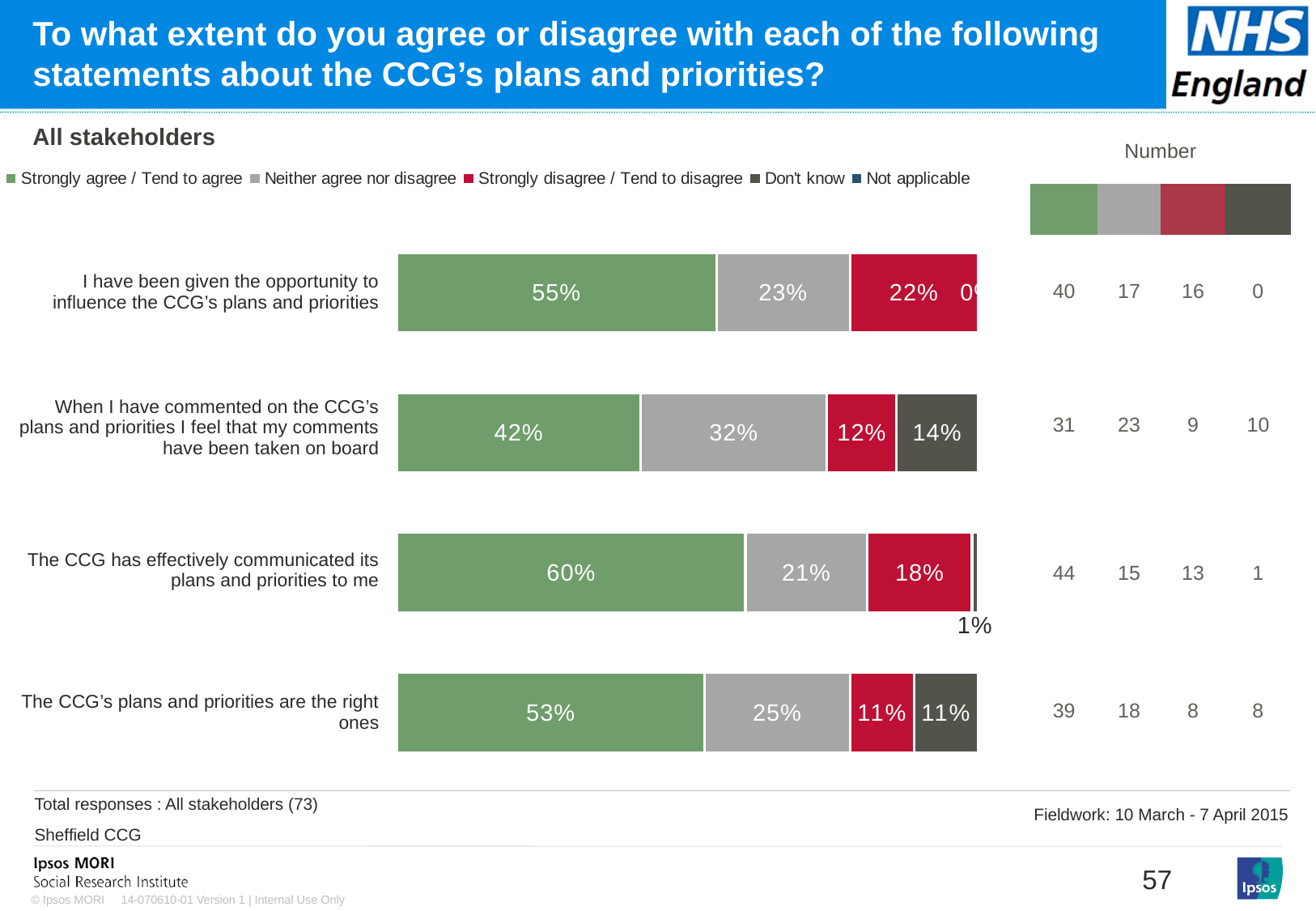
What percentage of stakeholders strongly disagree or tend to disagree that they have been given the opportunity to influence the CCG's plans and priorities? 22% What percentage of stakeholders neither agree nor disagree with the statement 'When I have commented on the CCG's plans and priorities I feel that my comments have been taken on board'? 32% Which is larger: the disagree share for 'I have been given the opportunity to influence the CCG's plans and priorities' or the disagree share for 'The CCG has effectively communicated its plans and priorities to me'? I have been given the opportunity to influence the CCG's plans and priorities What percentage of stakeholders answered 'Don't know' for the statement 'The CCG's plans and priorities are the right ones'? 11% Which statement has the lowest percentage of stakeholders who strongly agree or tend to agree? When I have commented on the CCG's plans and priorities I feel that my comments have been taken on board What is the total of the percentages shown in the bar for 'When I have commented on the CCG's plans and priorities I feel that my comments have been taken on board'? 100% How many response categories does the legend list? 5 What type of chart is used on this slide? Stacked bar chart What is the difference in percentage points between the agree share for 'The CCG has effectively communicated its plans and priorities to me' and the agree share for 'When I have commented on the CCG's plans and priorities I feel that my comments have been taken on board'? 18 percentage points How many statements are shown in the chart? 4 What percentage of stakeholders strongly agree or tend to agree that the CCG has effectively communicated its plans and priorities to them? 60% Which statement has the highest percentage of stakeholders who strongly agree or tend to agree? The CCG has effectively communicated its plans and priorities to me